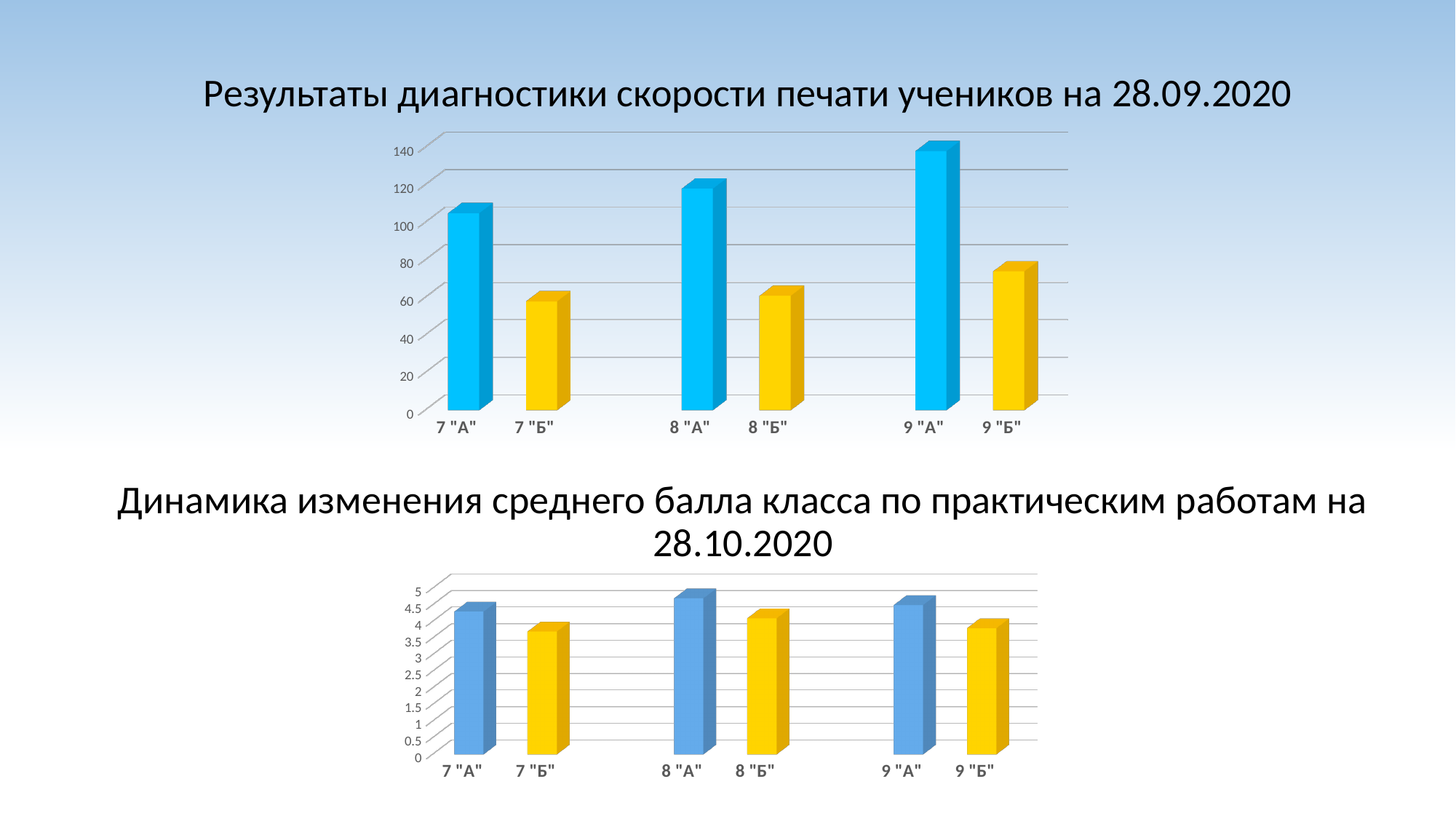
How many classes are shown in the top chart (Результаты диагностики скорости печати учеников на 28.09.2020)? 6 What is the title of the top chart on the slide? Результаты диагностики скорости печати учеников на 28.09.2020 In the top chart (Результаты диагностики скорости печати учеников на 28.09.2020), is the value for 9 "А" greater or less than 120? greater In the top chart (Результаты диагностики скорости печати учеников на 28.09.2020), which class has the lowest value? 7 "Б" In the top chart (Результаты диагностики скорости печати учеников на 28.09.2020), is the value for 8 "А" greater or less than 100? greater In the top chart (Результаты диагностики скорости печати учеников на 28.09.2020), is the value for 7 "Б" greater or less than 80? less In the bottom chart (Динамика изменения среднего балла класса по практическим работам на 28.10.2020), which is larger, the value for 9 "А" or 9 "Б"? 9 "А" In the top chart (Результаты диагностики скорости печати учеников на 28.09.2020), which is larger, the value for 8 "А" or 8 "Б"? 8 "А" In the top chart (Результаты диагностики скорости печати учеников на 28.09.2020), which class has the highest value? 9 "А" What kind of chart is the bottom chart (Динамика изменения среднего балла класса по практическим работам на 28.10.2020)? bar chart